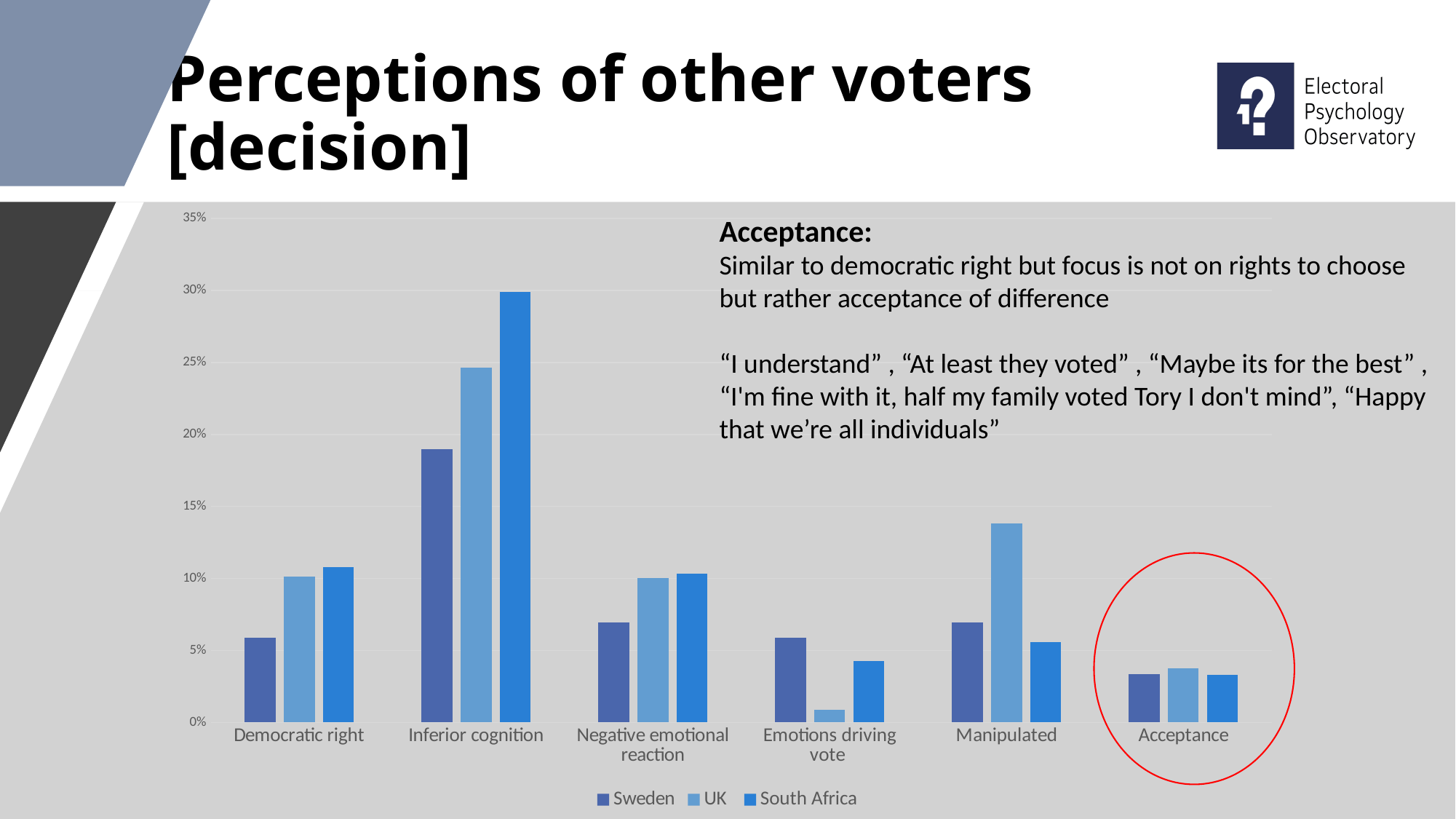
Is the value for South Africa in Inferior cognition greater or less than 25%? greater How many categories are shown on the x axis? 6 Is the value for the UK in Manipulated greater or less than 10%? greater How many series does the legend list? 3 Which category has the highest value for South Africa? Inferior cognition Which category has the lowest value for the UK? Emotions driving vote Which is larger in the Manipulated category: the UK value or the South Africa value? UK Which category is circled in red on the chart? Acceptance Which is larger in the Emotions driving vote category: the Sweden value or the UK value? Sweden What kind of chart is shown on the slide? bar chart Is the value for Sweden in Acceptance greater or less than 5%? less Which series is shown in the darkest blue in the legend? Sweden